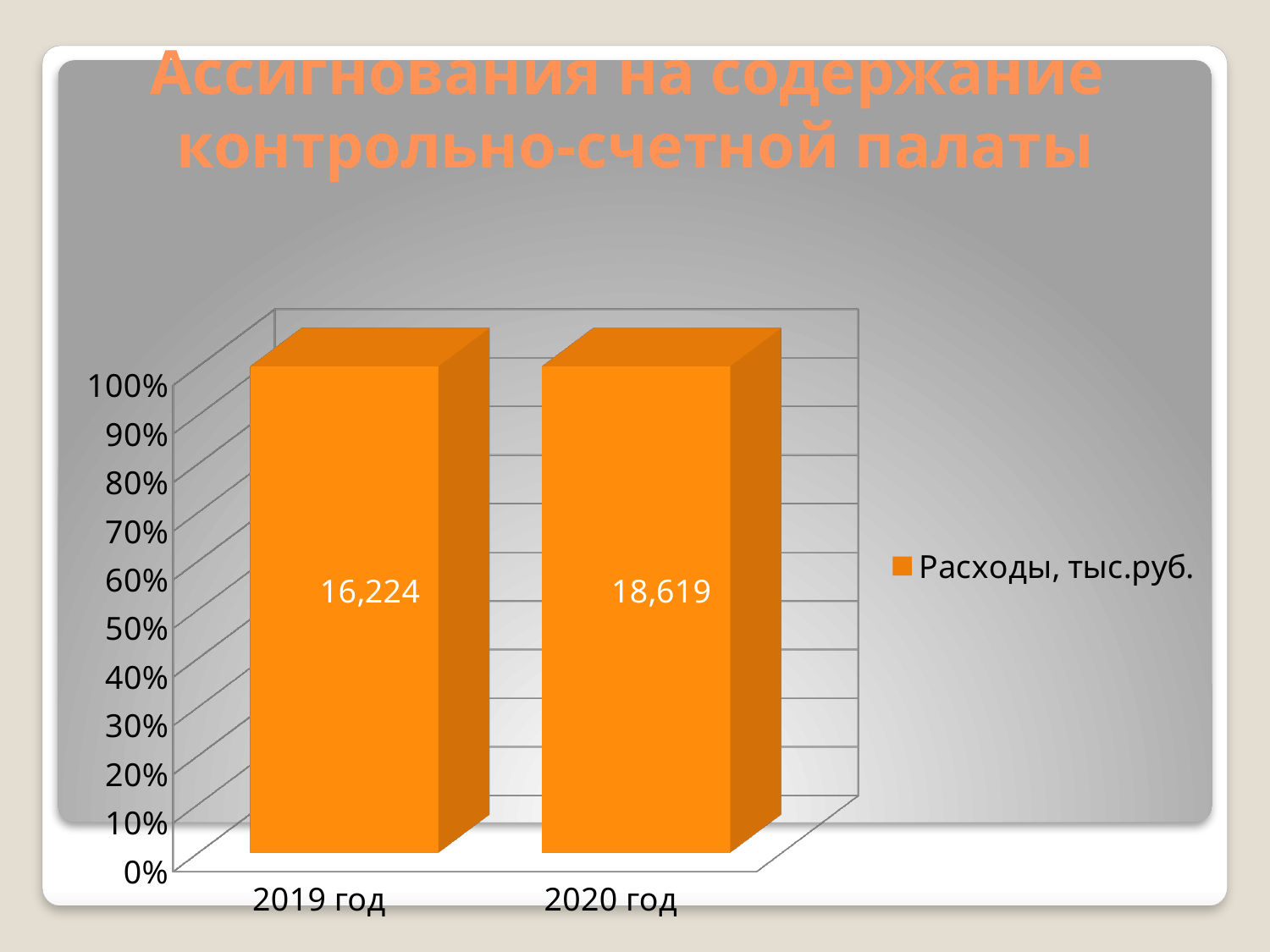
What kind of chart is shown on the slide? bar chart What is the difference between the labelled values for 2020 год and 2019 год? 2,395 Which category has the lowest labelled value? 2019 год What is the legend entry for the series shown? Расходы, тыс.руб. How many categories are shown on the x axis? 2 What is the value shown for 2020 год? 18,619 How many series does the legend list? 1 Which year has the larger labelled value, 2019 год or 2020 год? 2020 год What is the title of the chart? Ассигнования на содержание контрольно-счетной палаты Which category has the highest labelled value? 2020 год What is the value shown for 2019 год? 16,224 Do the labelled values rise or fall from 2019 год to 2020 год? rise